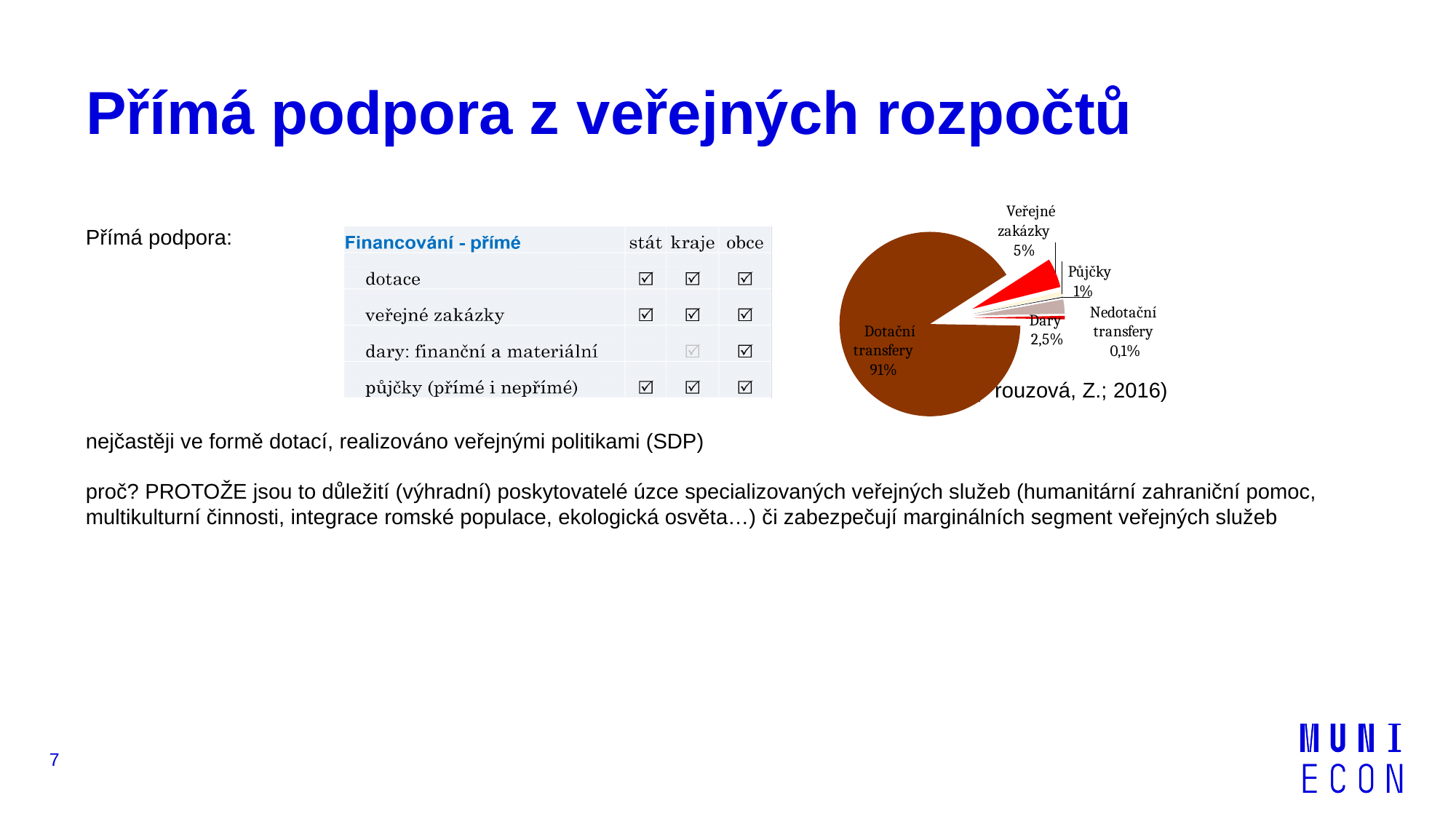
Which is larger in the pie chart, Veřejné zakázky or Dary? Veřejné zakázky What share of the pie chart does Dary have? 2,5% Which slice of the pie chart is the largest? Dotační transfery What kind of chart is shown on the slide? pie chart How many slices does the pie chart have? 6 What share of the pie chart does Nedotační transfery have? 0,1% What is the difference in percentage points between Veřejné zakázky and Půjčky in the pie chart? 4 What share of the pie chart does Dotační transfery have? 91% What share of the pie chart does Půjčky have? 1% What colour is the Dotační transfery slice in the pie chart? brown Which slice of the pie chart is the smallest? Nedotační transfery What share of the pie chart does Veřejné zakázky have? 5%